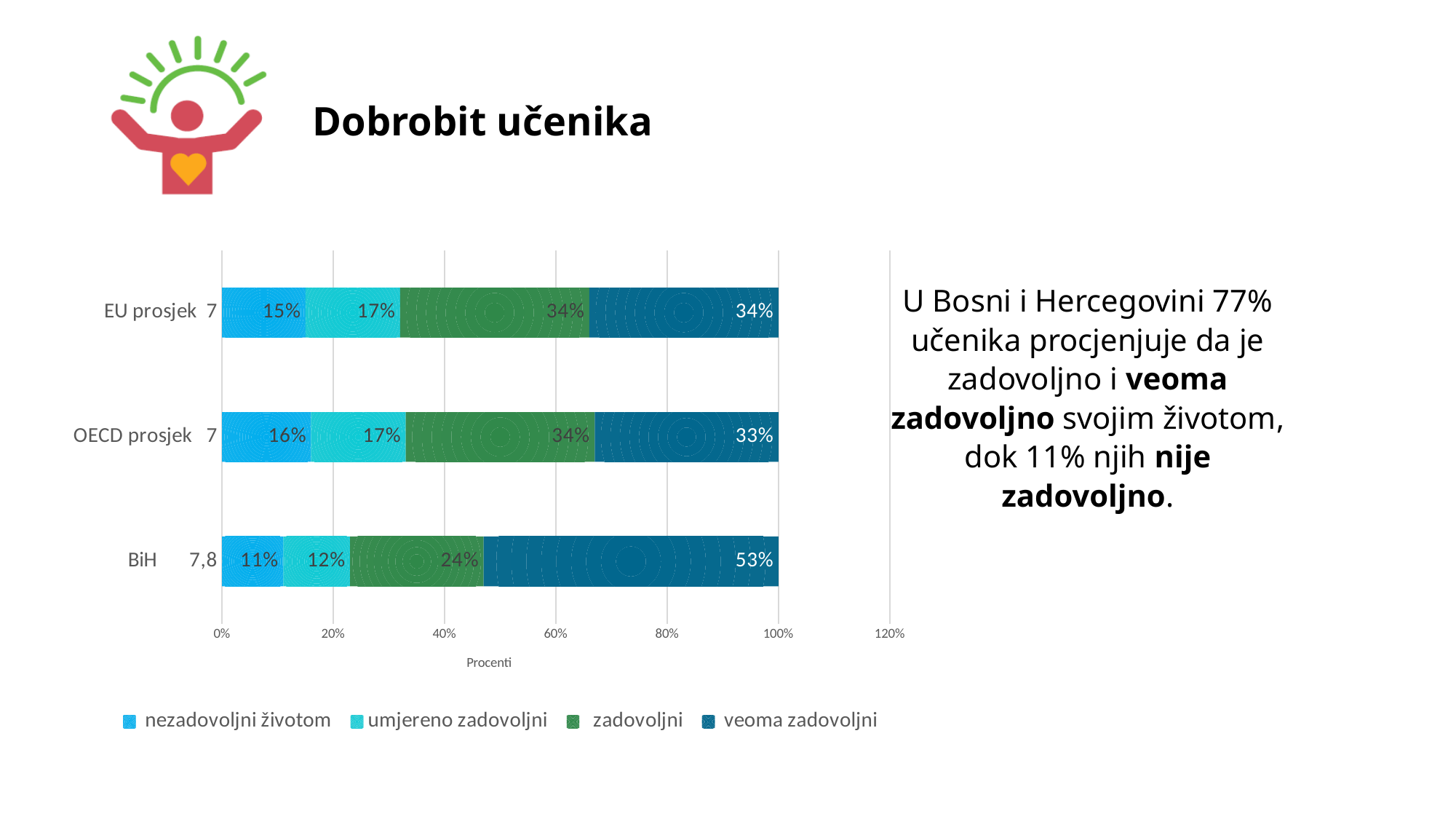
Which category has the lowest value for 'zadovoljni'? BiH What is the difference between the 'veoma zadovoljni' value for BiH and for OECD prosjek? 20% What kind of chart is shown on the slide? stacked bar chart Which category has the highest value for 'veoma zadovoljni'? BiH How many series does the legend list? 4 How many categories (bars) are shown in the chart? 3 What is the label of the horizontal axis? Procenti What is the value of 'veoma zadovoljni' for BiH? 53% What is the value of 'nezadovoljni životom' for OECD prosjek? 16% What is the value of 'zadovoljni' for EU prosjek? 34% Which is larger: the 'nezadovoljni životom' value for EU prosjek or for OECD prosjek? OECD prosjek What is the value of 'umjereno zadovoljni' for BiH? 12%